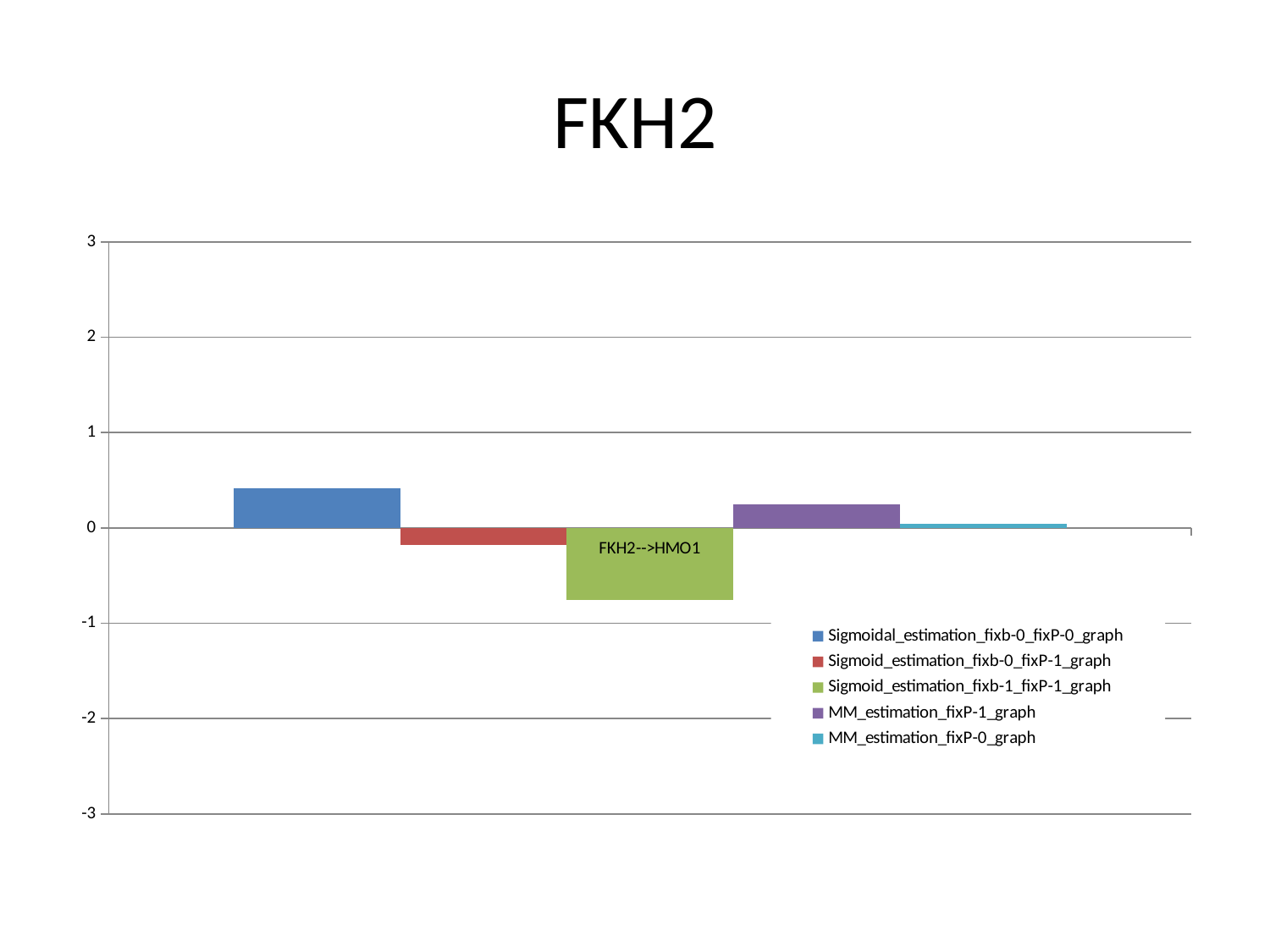
How many series does the legend list? 5 Which series has the highest value for FKH2-->HMO1? Sigmoidal_estimation_fixb-0_fixP-0_graph Is the value for Sigmoidal_estimation_fixb-0_fixP-0_graph greater or less than 1? less How many categories are plotted on the x axis? 1 Is the value for Sigmoid_estimation_fixb-1_fixP-1_graph greater or less than 0? less What is the label of the category shown on the chart? FKH2-->HMO1 Which is larger, the value for Sigmoidal_estimation_fixb-0_fixP-0_graph or the value for MM_estimation_fixP-1_graph? Sigmoidal_estimation_fixb-0_fixP-0_graph What kind of chart is shown on the slide? bar chart What is the title of the chart? FKH2 Which series has the lowest value for FKH2-->HMO1? Sigmoid_estimation_fixb-1_fixP-1_graph Is the value for Sigmoid_estimation_fixb-1_fixP-1_graph greater or less than -1? greater Which is larger, the value for Sigmoid_estimation_fixb-0_fixP-1_graph or the value for Sigmoid_estimation_fixb-1_fixP-1_graph? Sigmoid_estimation_fixb-0_fixP-1_graph